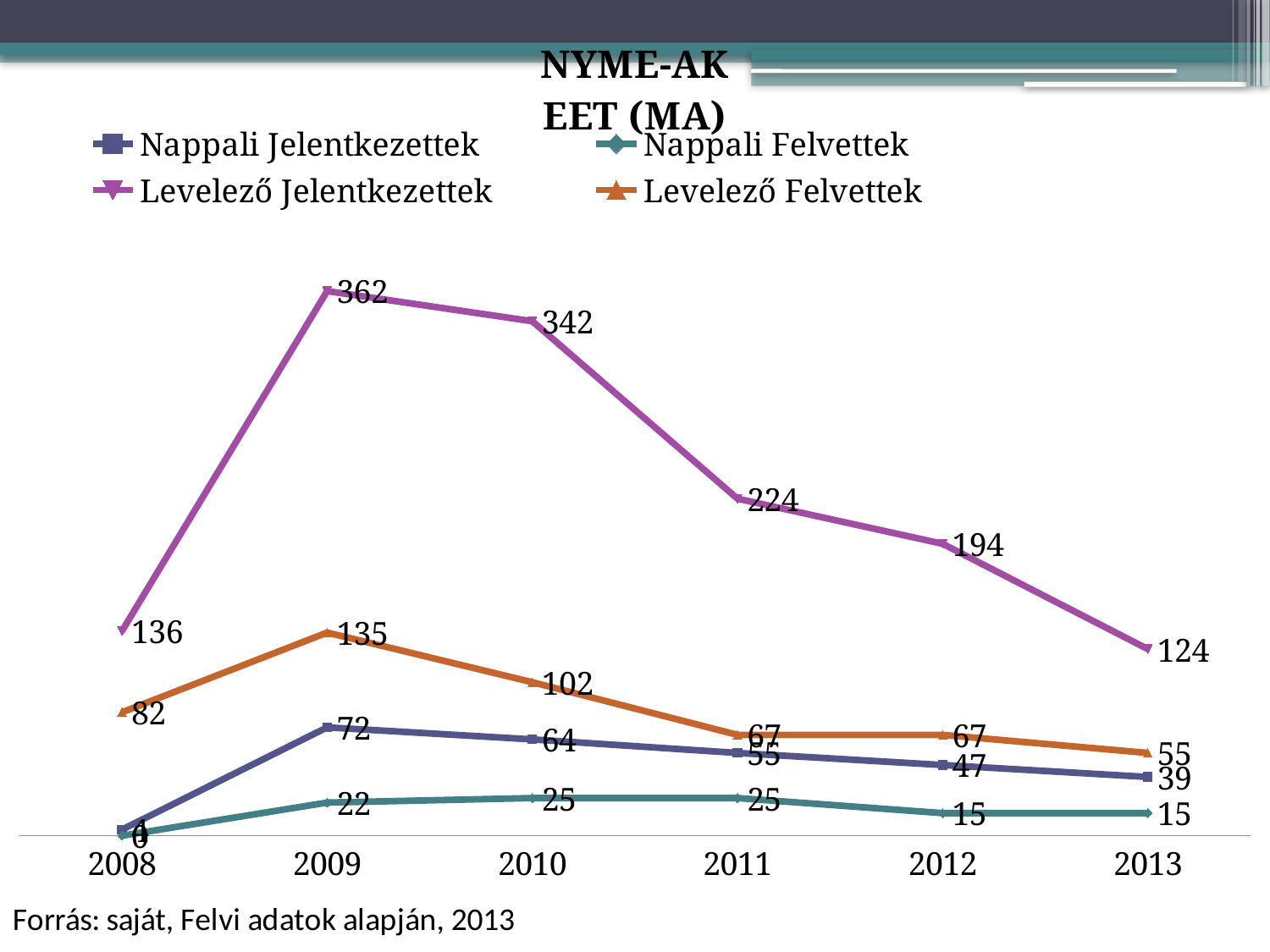
In which year is Levelező Felvettek lowest? 2013 Which is larger in 2011: Levelező Felvettek or Nappali Jelentkezettek? Levelező Felvettek What is the value for Nappali Felvettek in 2013? 15 How many series does the legend list? 4 In which year is Levelező Jelentkezettek highest? 2009 What is the value for Levelező Felvettek in 2010? 102 Does Levelező Jelentkezettek rise or fall from 2009 to 2013? fall What is the value for Levelező Jelentkezettek in 2009? 362 How many years are shown on the x axis? 6 What is the value for Nappali Jelentkezettek in 2012? 47 What type of chart is shown on the slide? line chart What is the difference between Levelező Jelentkezettek in 2009 and in 2013? 238